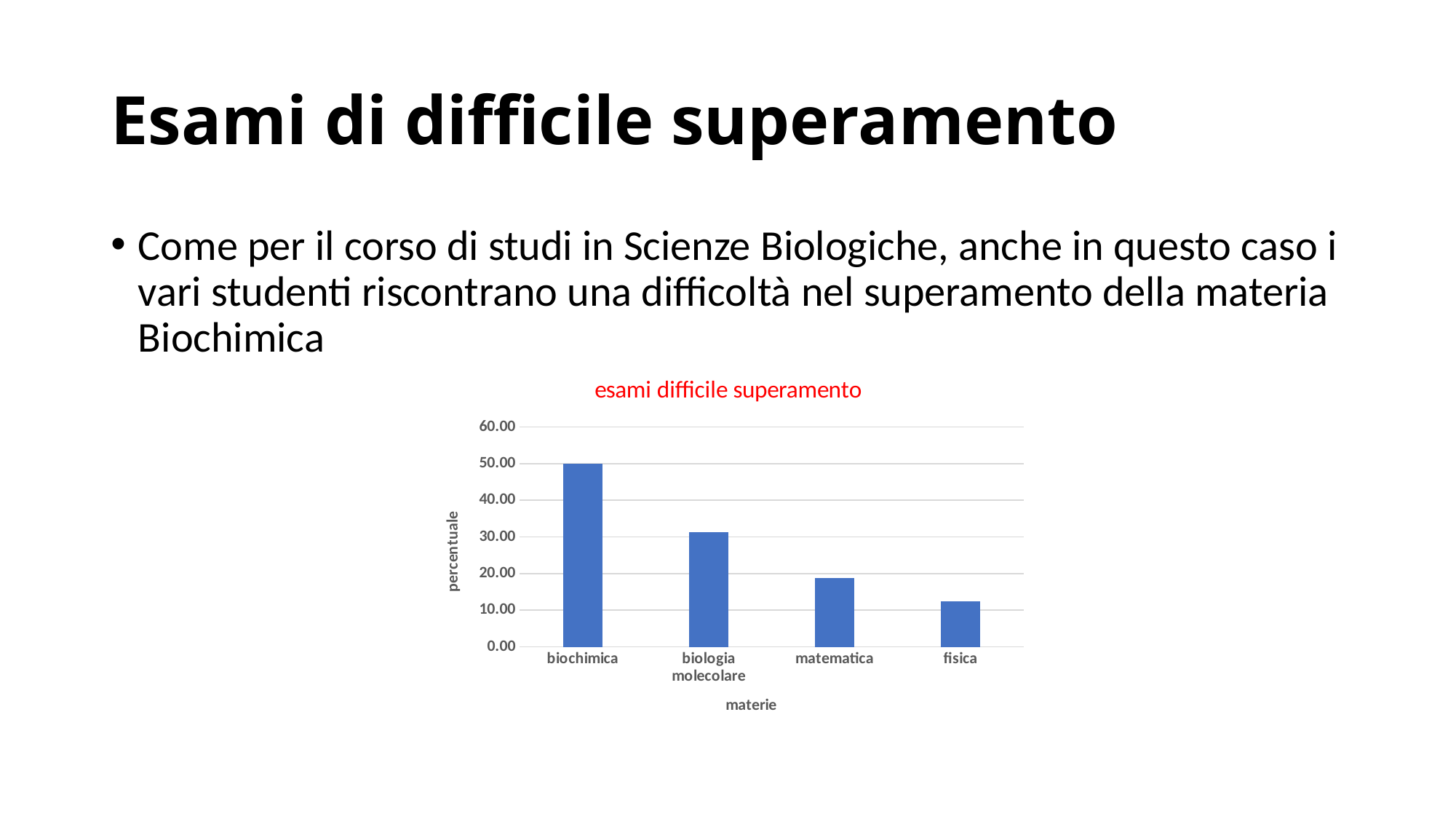
Is the value for matematica greater or less than 10.00? greater Is the value for biologia molecolare greater or less than 40.00? less What kind of chart is shown on the slide? bar chart Do the values rise or fall moving from left to right along the x axis? fall Is the value for fisica greater or less than 20.00? less Which materia has the lowest percentuale in the chart? fisica Which is larger, the value for biologia molecolare or the value for matematica? biologia molecolare How many categories (materie) are shown on the x axis of the chart? 4 Which materia has the highest percentuale in the chart? biochimica What is the title of the chart? esami difficile superamento What is the percentuale value for biochimica? 50.00 What is the label of the y axis of the chart? percentuale